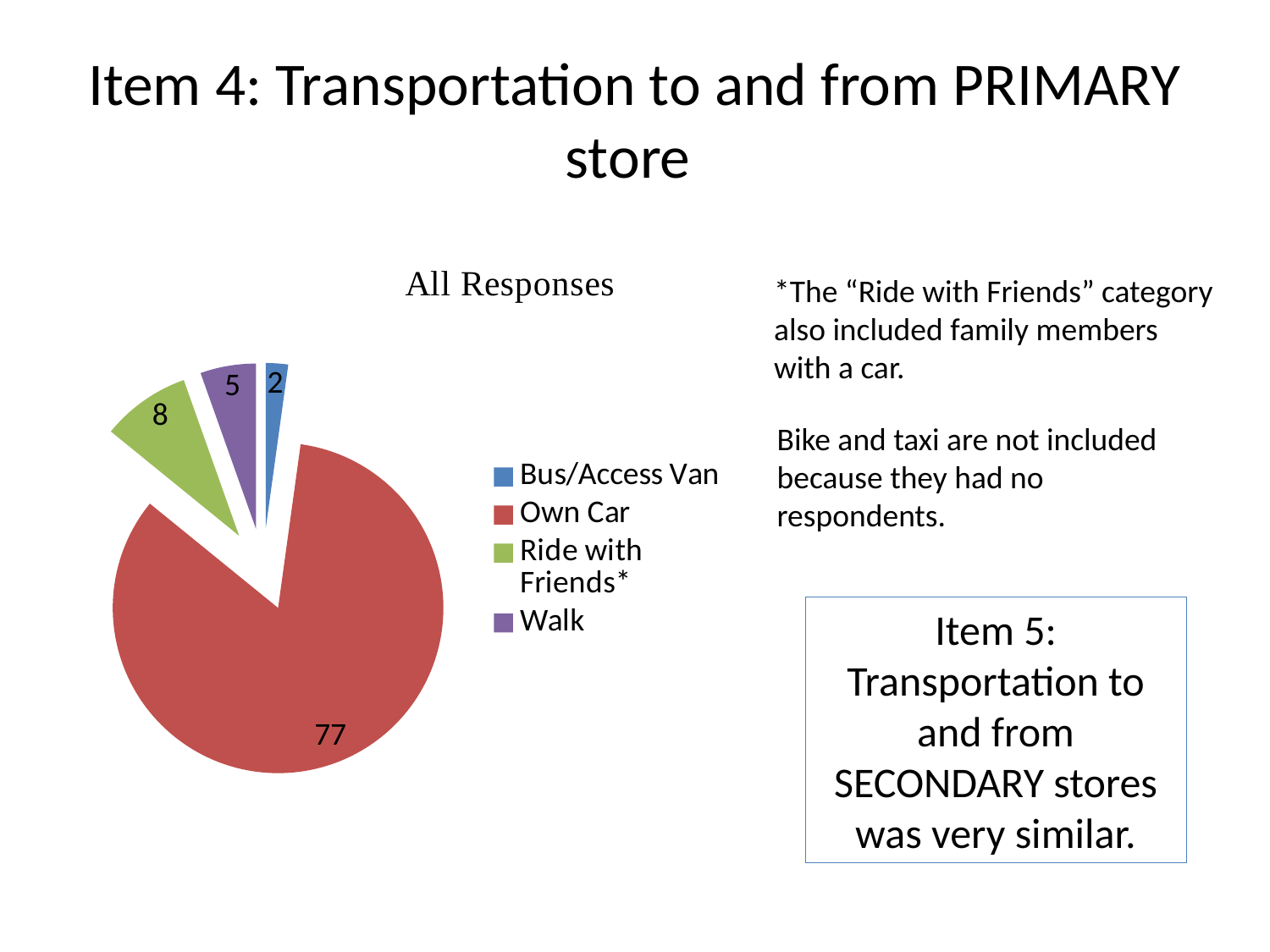
What is the difference between the Own Car value and the Ride with Friends* value? 69 What is the value for Bus/Access Van in the pie chart? 2 What is the title of the pie chart? All Responses What is the total of all the values shown in the pie chart? 92 Which category has the smallest slice in the pie chart? Bus/Access Van What is the value for Ride with Friends* in the pie chart? 8 What is the value for Walk in the pie chart? 5 What is the value for Own Car in the pie chart? 77 How many categories does the pie chart's legend list? 4 Which category has the largest slice in the pie chart? Own Car What kind of chart is shown on the slide? Pie chart Which is larger, the value for Walk or the value for Bus/Access Van? Walk